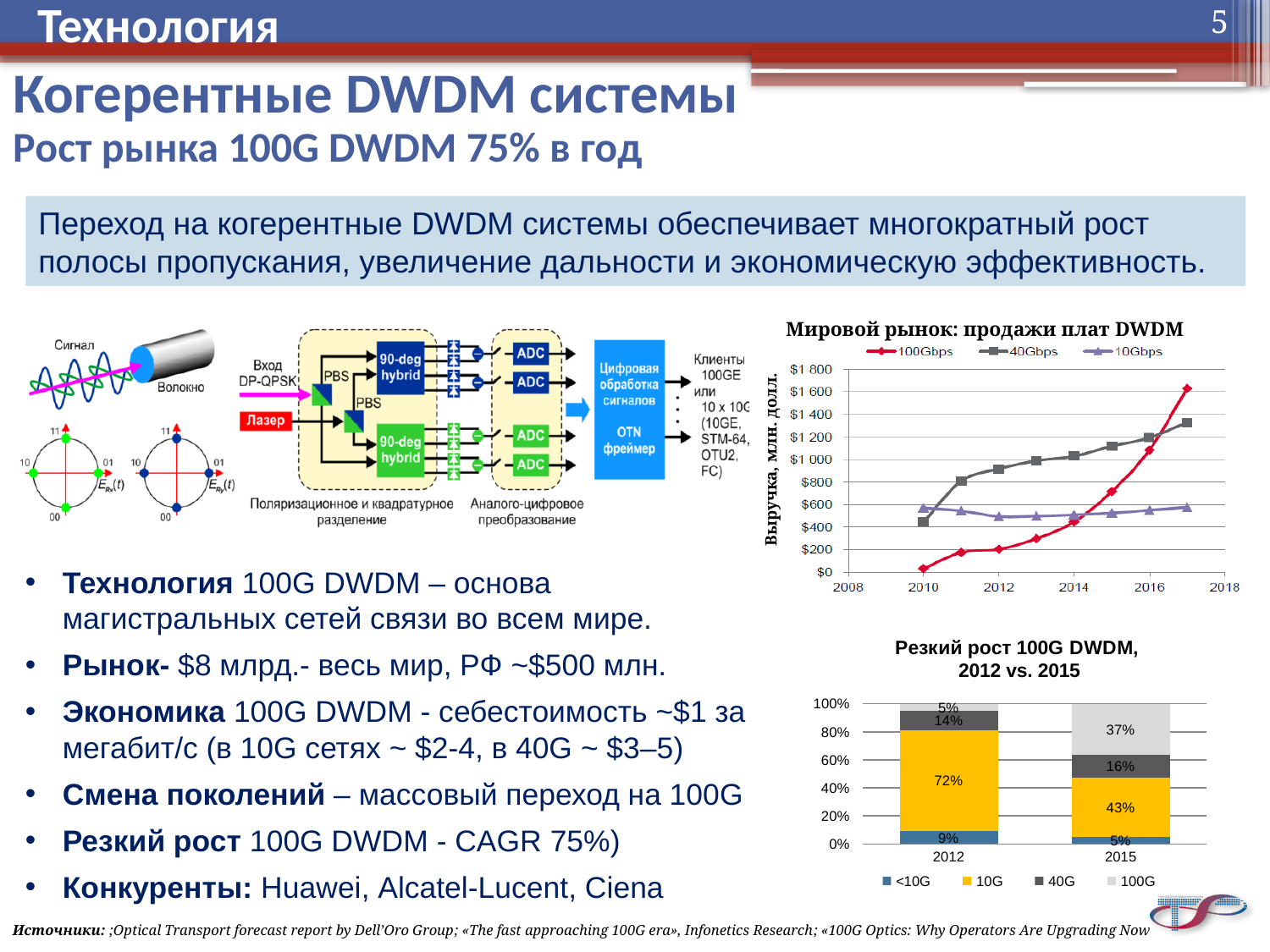
In the chart "Резкий рост 100G DWDM, 2012 vs. 2015", what is the share of 10G in 2012? 72% In the chart "Резкий рост 100G DWDM, 2012 vs. 2015", which is larger: the 10G share in 2012 or the 10G share in 2015? 2012 In the chart "Мировой рынок: продажи плат DWDM", does the 100Gbps series rise or fall from 2010 to 2017? rise What kind of chart is "Мировой рынок: продажи плат DWDM"? line chart In the chart "Резкий рост 100G DWDM, 2012 vs. 2015", how many categories are shown on the x axis? 2 In the chart "Мировой рынок: продажи плат DWDM", is the value for 40Gbps in 2010 greater or less than $600? less In the chart titled "Мировой рынок: продажи плат DWDM", how many series does the legend list? 3 In the chart "Резкий рост 100G DWDM, 2012 vs. 2015", what is the share of 100G in 2015? 37% In the chart "Мировой рынок: продажи плат DWDM", is the value for 100Gbps in 2017 greater or less than $1 400? greater In the chart "Резкий рост 100G DWDM, 2012 vs. 2015", by how many percentage points did the 100G share change from 2012 to 2015? 32% In the chart "Резкий рост 100G DWDM, 2012 vs. 2015", what is the share of 40G in 2015? 16% In the chart "Мировой рынок: продажи плат DWDM", which series has the highest value in 2017? 100Gbps